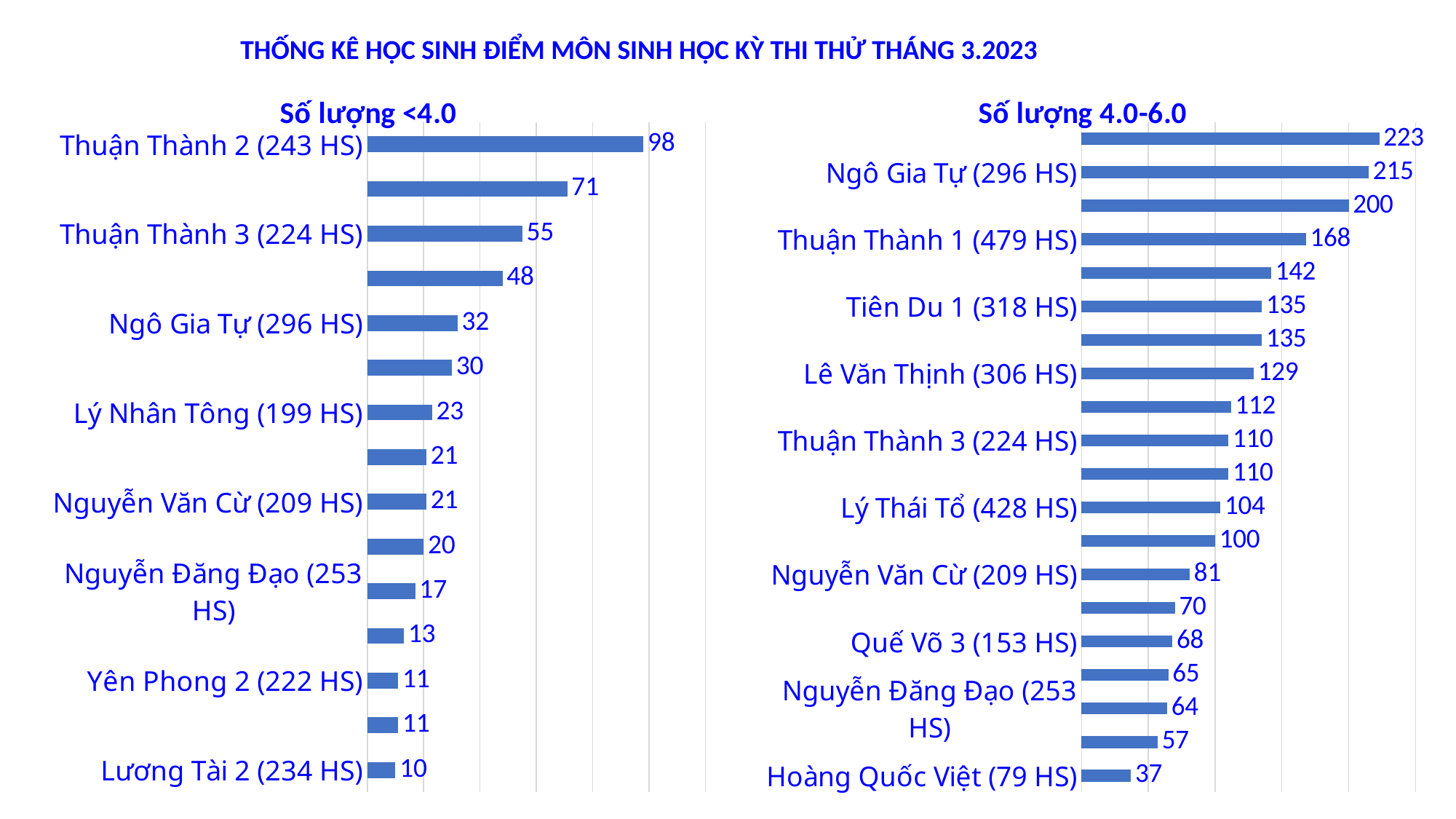
What type of chart is the 'Số lượng <4.0' chart? Bar chart In the 'Số lượng <4.0' chart, which category has the lowest value? Lương Tài 2 (234 HS) In the 'Số lượng 4.0-6.0' chart, what is the value for Hoàng Quốc Việt (79 HS)? 37 In the 'Số lượng 4.0-6.0' chart, what is the value for Thuận Thành 1 (479 HS)? 168 How many bars are plotted in the 'Số lượng 4.0-6.0' chart? 20 In the 'Số lượng 4.0-6.0' chart, which is larger: Lê Văn Thịnh (306 HS) or Lý Thái Tổ (428 HS)? Lê Văn Thịnh (306 HS) In the 'Số lượng <4.0' chart, what is the value for Ngô Gia Tự (296 HS)? 32 In the 'Số lượng <4.0' chart, what is the difference between Thuận Thành 2 (243 HS) and Thuận Thành 3 (224 HS)? 43 In the 'Số lượng <4.0' chart, what is the value for Thuận Thành 2 (243 HS)? 98 In the 'Số lượng 4.0-6.0' chart, which category has the lowest value? Hoàng Quốc Việt (79 HS) In the 'Số lượng <4.0' chart, which category has the highest value? Thuận Thành 2 (243 HS) In the 'Số lượng 4.0-6.0' chart, what is the difference between Ngô Gia Tự (296 HS) and Nguyễn Văn Cừ (209 HS)? 134